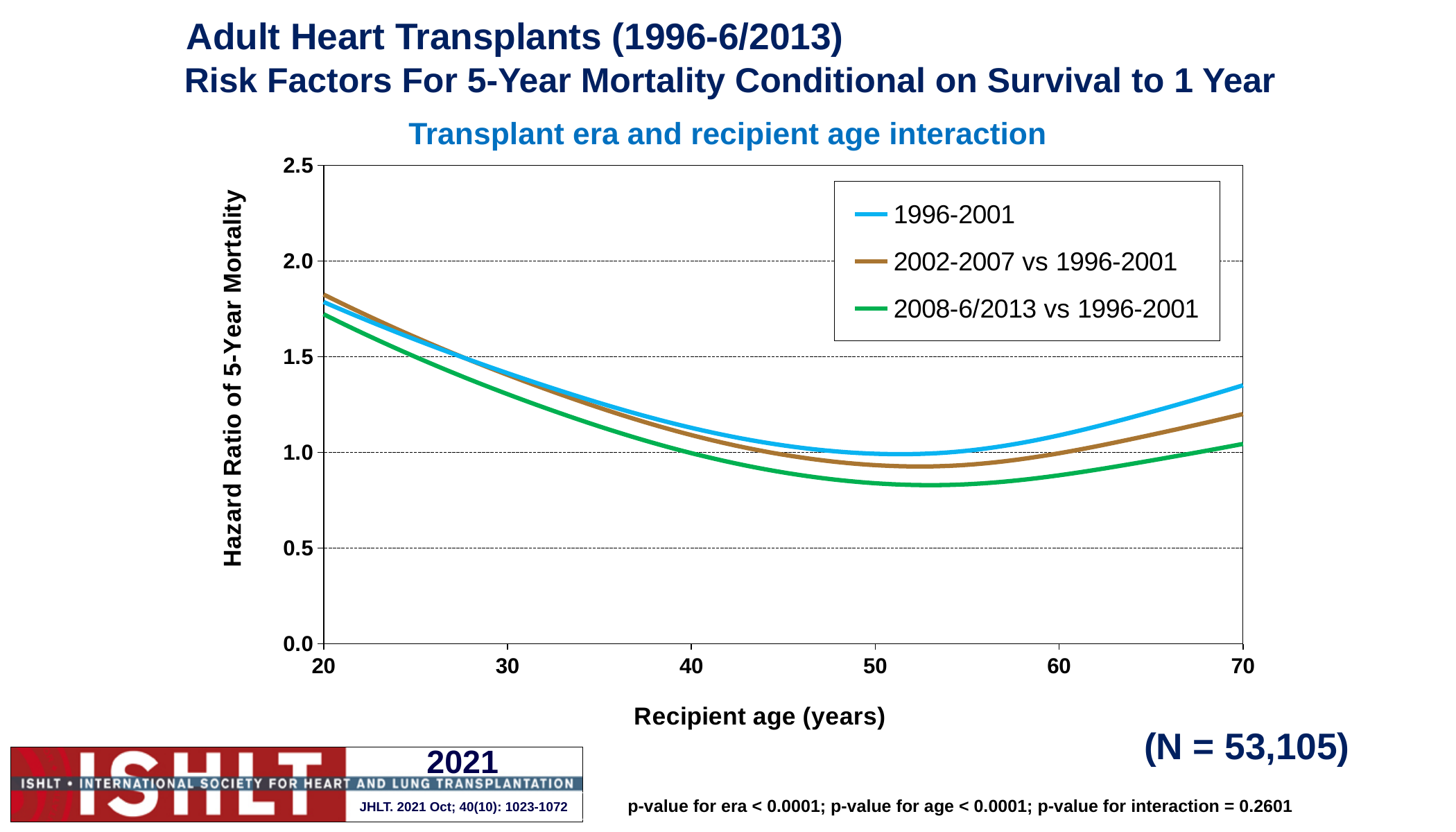
At recipient age 60, which series has the higher hazard ratio: 1996-2001 or 2008-6/2013 vs 1996-2001? 1996-2001 Is the hazard ratio for the 1996-2001 series at recipient age 70 greater or less than 1.0? greater Does the hazard ratio for the 1996-2001 series rise or fall as recipient age increases from 20 to 50? fall Is the hazard ratio for the 2008-6/2013 vs 1996-2001 series at recipient age 50 greater or less than 1.0? less What are the three series named in the legend? 1996-2001; 2002-2007 vs 1996-2001; 2008-6/2013 vs 1996-2001 Which series has the lowest hazard ratio at recipient age 40? 2008-6/2013 vs 1996-2001 Is the hazard ratio for the 2008-6/2013 vs 1996-2001 series at recipient age 30 greater or less than 1.5? less Does the hazard ratio for the 2002-2007 vs 1996-2001 series rise or fall as recipient age increases from 55 to 70? rise How many series does the legend list? 3 What kind of chart is shown on the slide? line chart What is the label of the y axis? Hazard Ratio of 5-Year Mortality